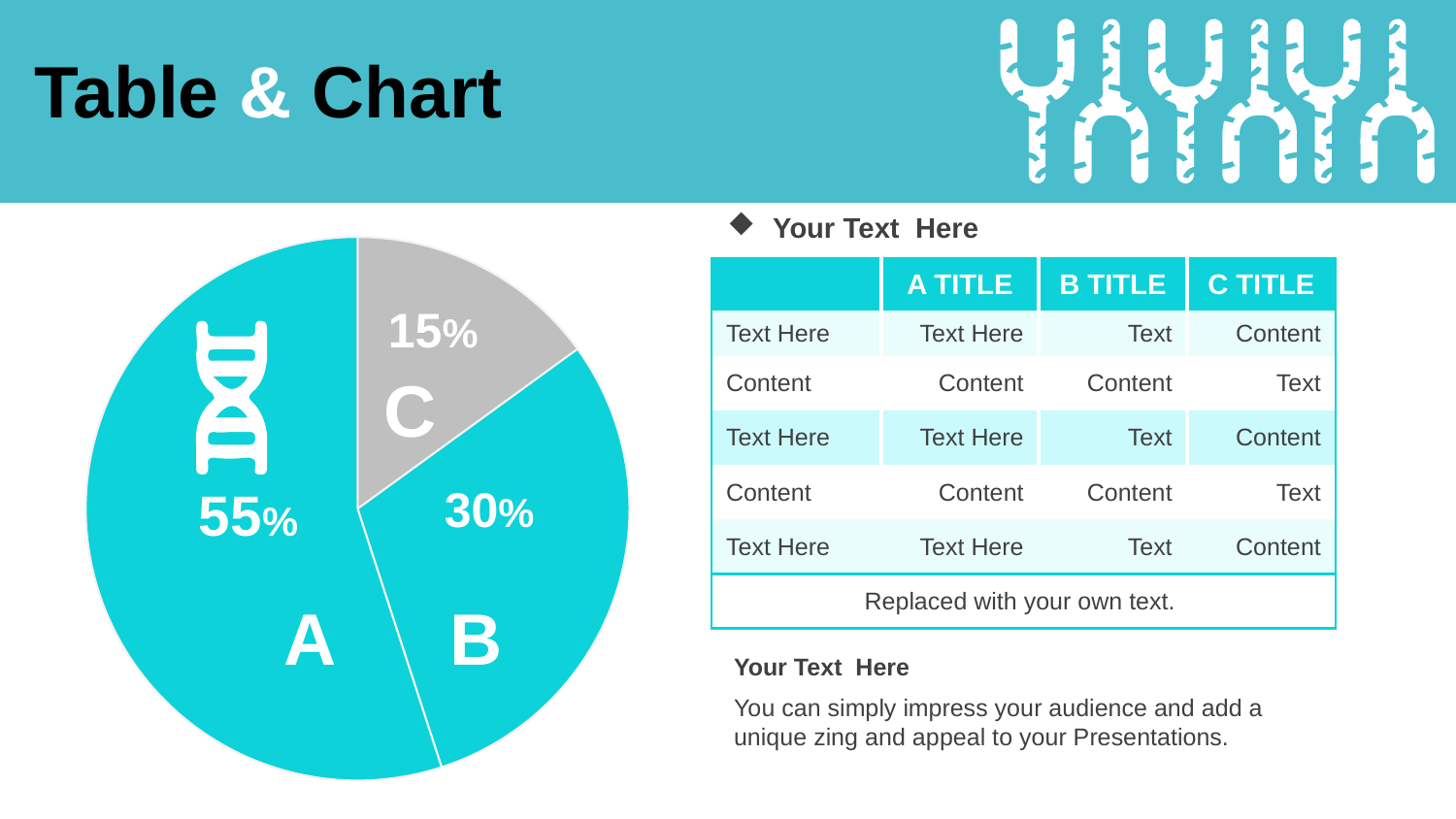
Which slice of the pie chart is the largest? A What percentage does slice C represent in the pie chart? 15% Which is larger, slice B or slice C? B How many slices does the pie chart have? 3 What percentage does slice B represent in the pie chart? 30% What is the combined share of slices A and B? 85% What colour is slice C in the pie chart? grey Which slice of the pie chart is the smallest? C What is the difference in percentage points between slice A and slice B? 25 What percentage does slice A represent in the pie chart? 55% What is the difference in percentage points between slice B and slice C? 15 What kind of chart is shown on the slide? pie chart